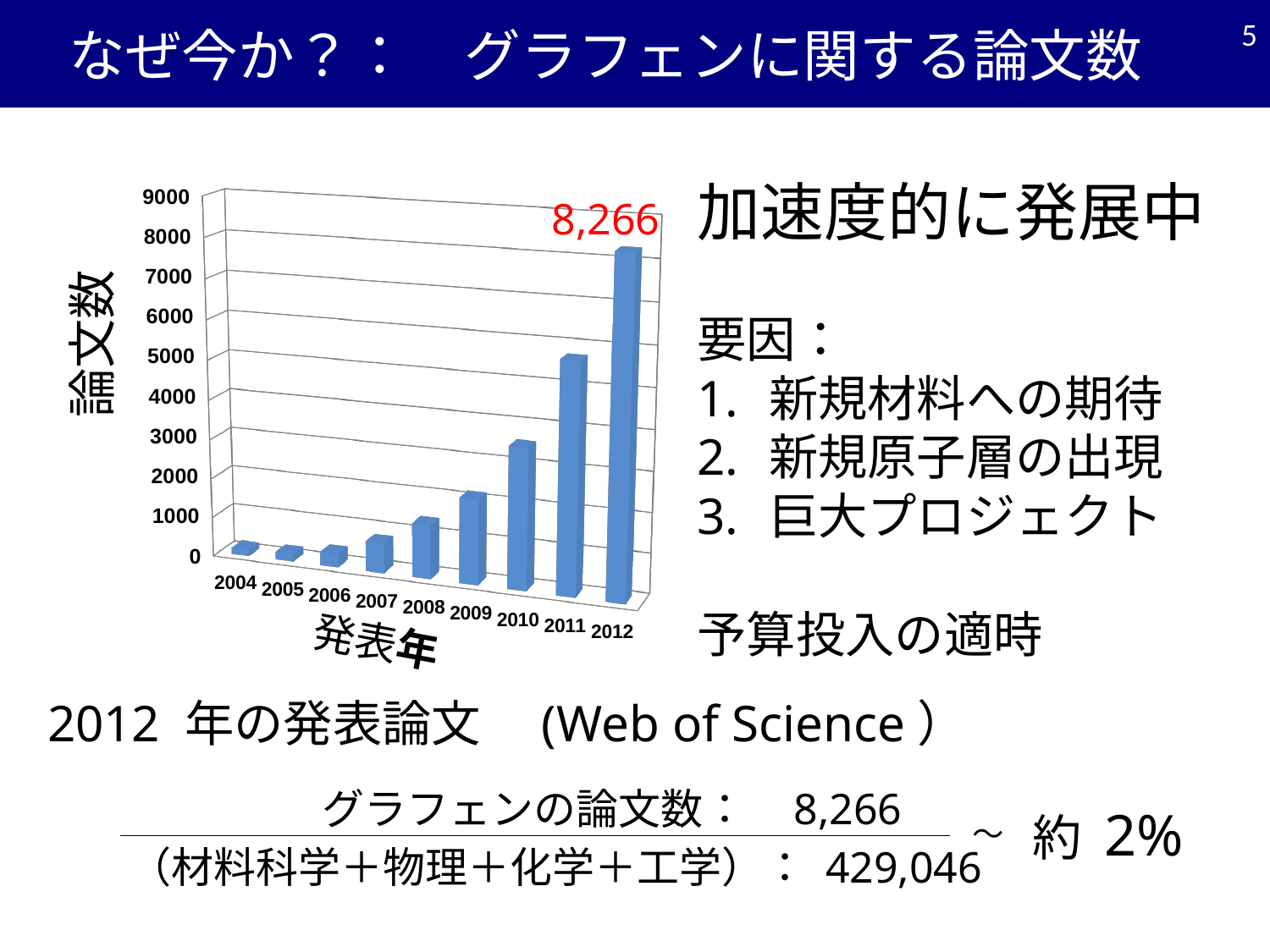
Is the value for 2007 greater or less than 1000? less Which year has the highest number of papers? 2012 Do the values rise or fall from 2004 to 2012? rise What kind of chart is shown on the slide? bar chart Which year has the larger value, 2010 or 2011? 2011 What is the label on the y axis of the chart? 論文数 Is the value for 2011 greater or less than 3000? greater What is the number of papers shown for 2012? 8,266 How many years are shown on the x axis? 9 Is the value for 2010 greater or less than 2000? greater What is the label on the x axis of the chart? 発表年